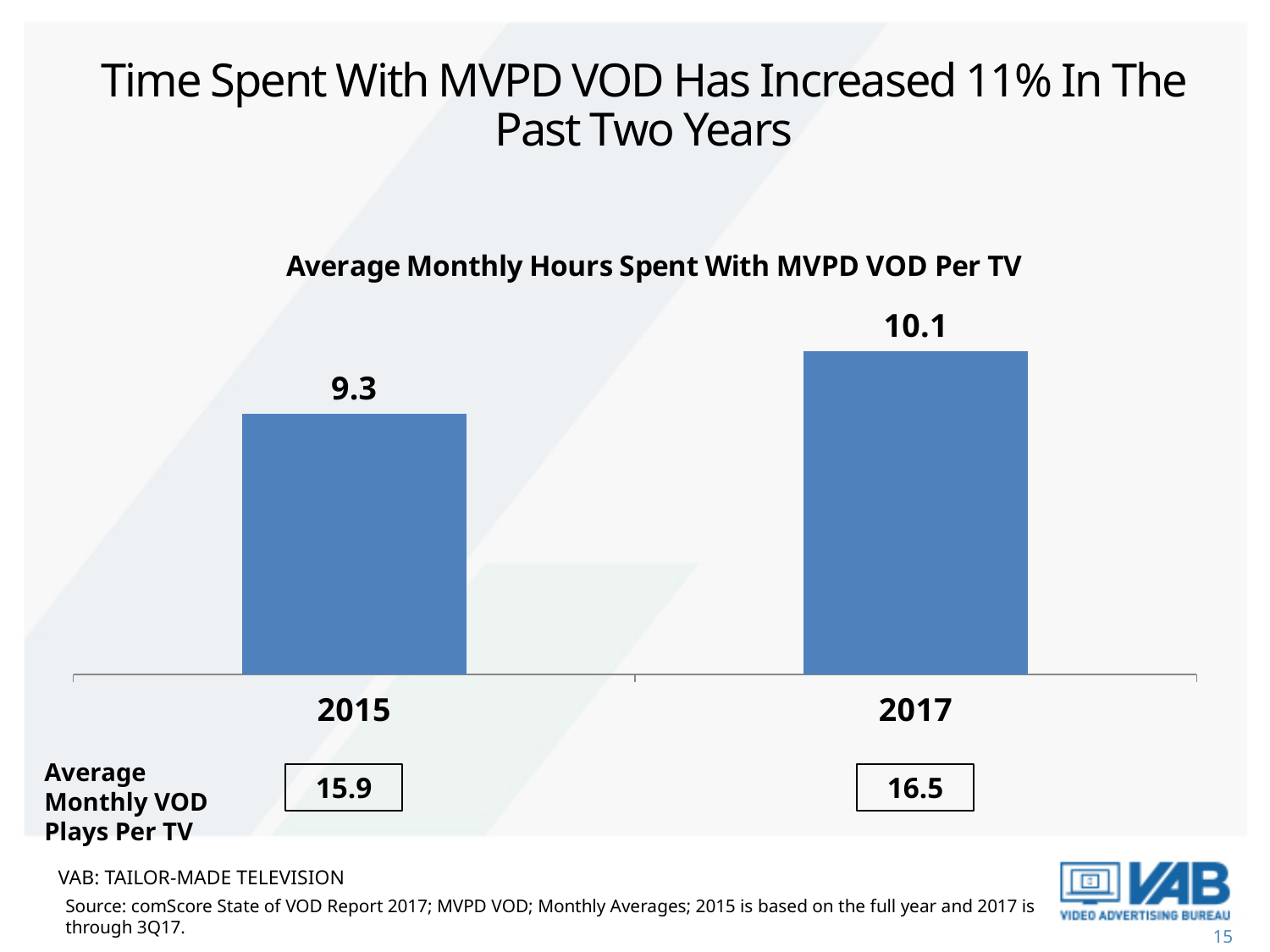
Which year has the higher average monthly hours spent with MVPD VOD per TV? 2017 Which year has the lower average monthly hours spent with MVPD VOD per TV? 2015 By how much did average monthly hours spent with MVPD VOD per TV increase from 2015 to 2017? 0.8 Do the values rise or fall from 2015 to 2017? rise What is the average monthly hours spent with MVPD VOD per TV in 2015? 9.3 What is the average monthly VOD plays per TV shown below the chart for 2015? 15.9 What is the average monthly VOD plays per TV shown below the chart for 2017? 16.5 What is the average monthly hours spent with MVPD VOD per TV in 2017? 10.1 Is the value for 2017 larger or smaller than the value for 2015? larger How many years are shown on the chart? 2 What is the title of the chart? Average Monthly Hours Spent With MVPD VOD Per TV What kind of chart is shown on the slide? bar chart